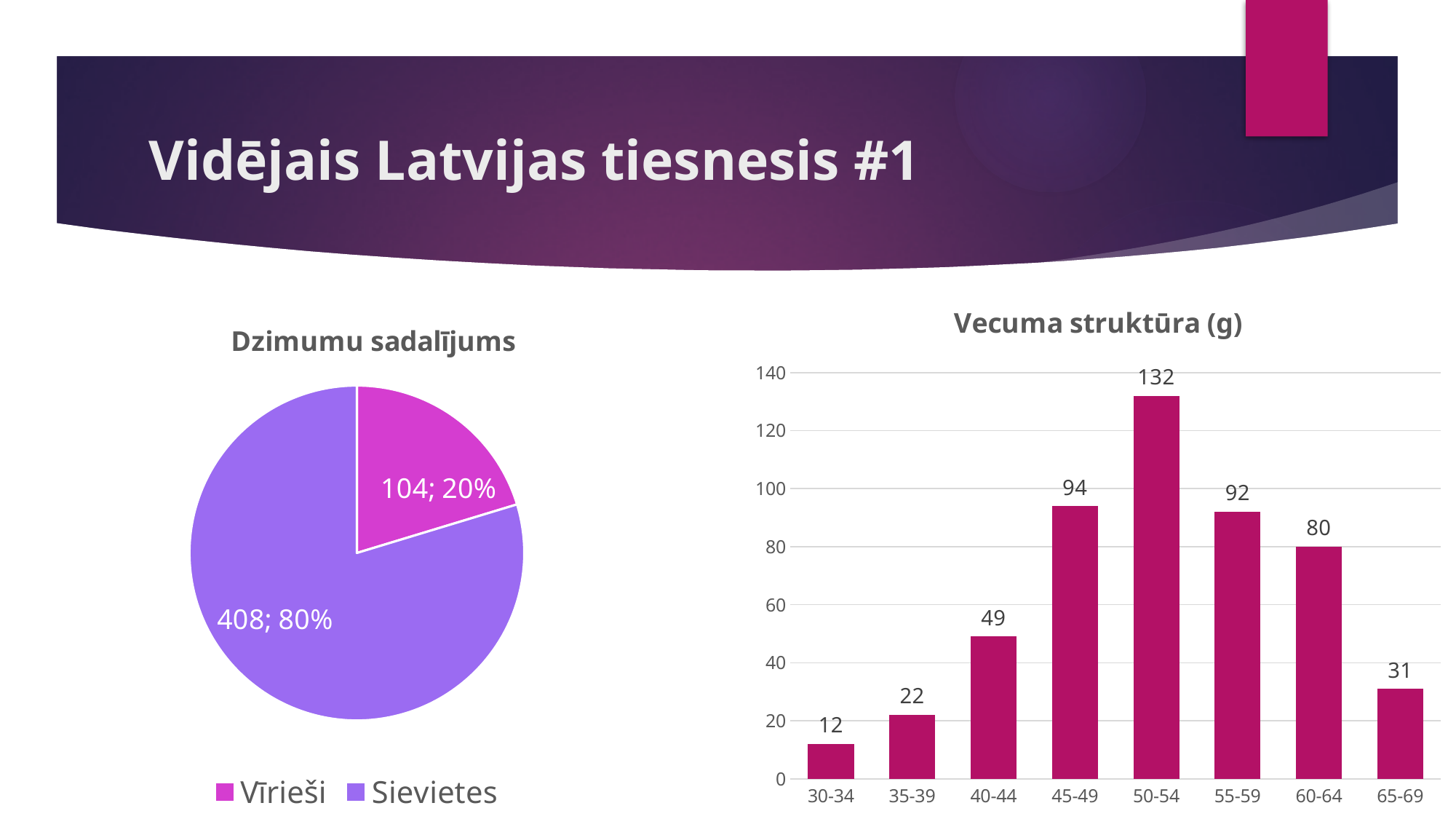
In the 'Vecuma struktūra (g)' chart, which is larger, the value for 40-44 or the value for 65-69? 40-44 In the 'Vecuma struktūra (g)' chart, which age group has the highest value? 50-54 What kind of chart is 'Vecuma struktūra (g)'? bar chart In the 'Vecuma struktūra (g)' chart, which age group has the lowest value? 30-34 What kind of chart is 'Dzimumu sadalījums'? pie chart How many entries does the legend of the 'Dzimumu sadalījums' chart list? 2 How many age groups are shown in the 'Vecuma struktūra (g)' chart? 8 In the 'Vecuma struktūra (g)' chart, what is the difference between the values for 50-54 and 55-59? 40 In the 'Dzimumu sadalījums' chart, what share of the pie does Sievietes take? 80% In the 'Vecuma struktūra (g)' chart, what is the value for 45-49? 94 In the 'Vecuma struktūra (g)' chart, is the value for 60-64 greater or less than 100? less In the 'Dzimumu sadalījums' chart, what value is shown for Vīrieši? 104; 20%